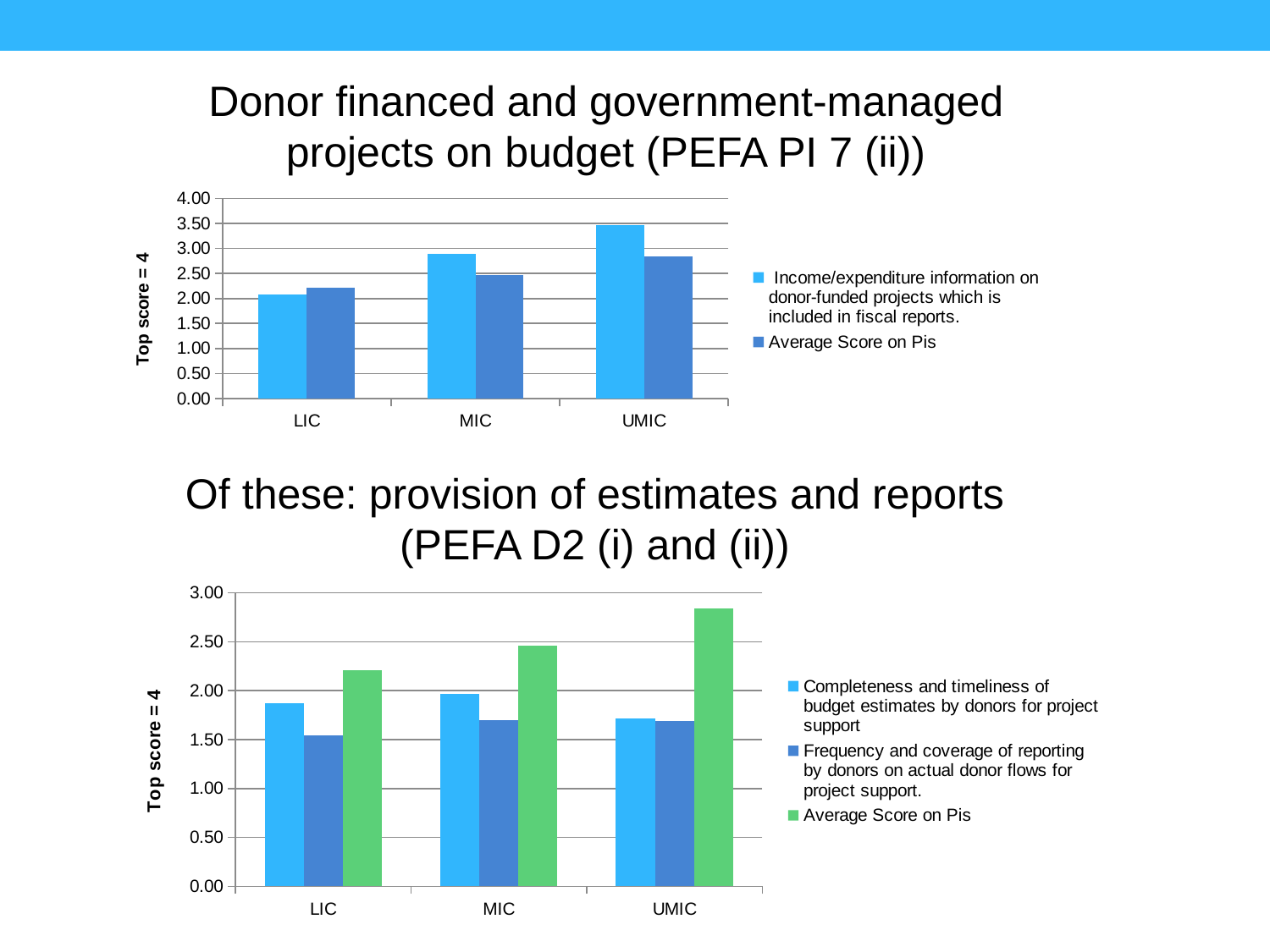
In the bottom chart (Of these: provision of estimates and reports), for MIC, which is larger: 'Completeness and timeliness of budget estimates by donors for project support' or 'Average Score on Pis'? Average Score on Pis In the top chart (Donor financed and government-managed projects on budget), is the value for UMIC in the 'Income/expenditure information' series greater or less than 3.00? greater In the top chart (Donor financed and government-managed projects on budget), which category has the lowest value for 'Average Score on Pis'? LIC In the bottom chart (Of these: provision of estimates and reports), is the value for LIC in the 'Frequency and coverage of reporting by donors on actual donor flows for project support' series greater or less than 2.00? less In the top chart (Donor financed and government-managed projects on budget), which category has the highest value for 'Income/expenditure information on donor-funded projects which is included in fiscal reports'? UMIC In the top chart (Donor financed and government-managed projects on budget), does the 'Income/expenditure information' series rise or fall from LIC to UMIC? rise In the top chart (Donor financed and government-managed projects on budget), what kind of chart is shown? bar chart In the top chart (Donor financed and government-managed projects on budget), how many categories are shown on the x axis? 3 In the bottom chart (Of these: provision of estimates and reports), how many series does the legend list? 3 In the bottom chart (Of these: provision of estimates and reports), which category has the highest value for 'Average Score on Pis'? UMIC In the top chart (Donor financed and government-managed projects on budget), how many series does the legend list? 2 In the bottom chart (Of these: provision of estimates and reports), what is the y-axis label? Top score = 4